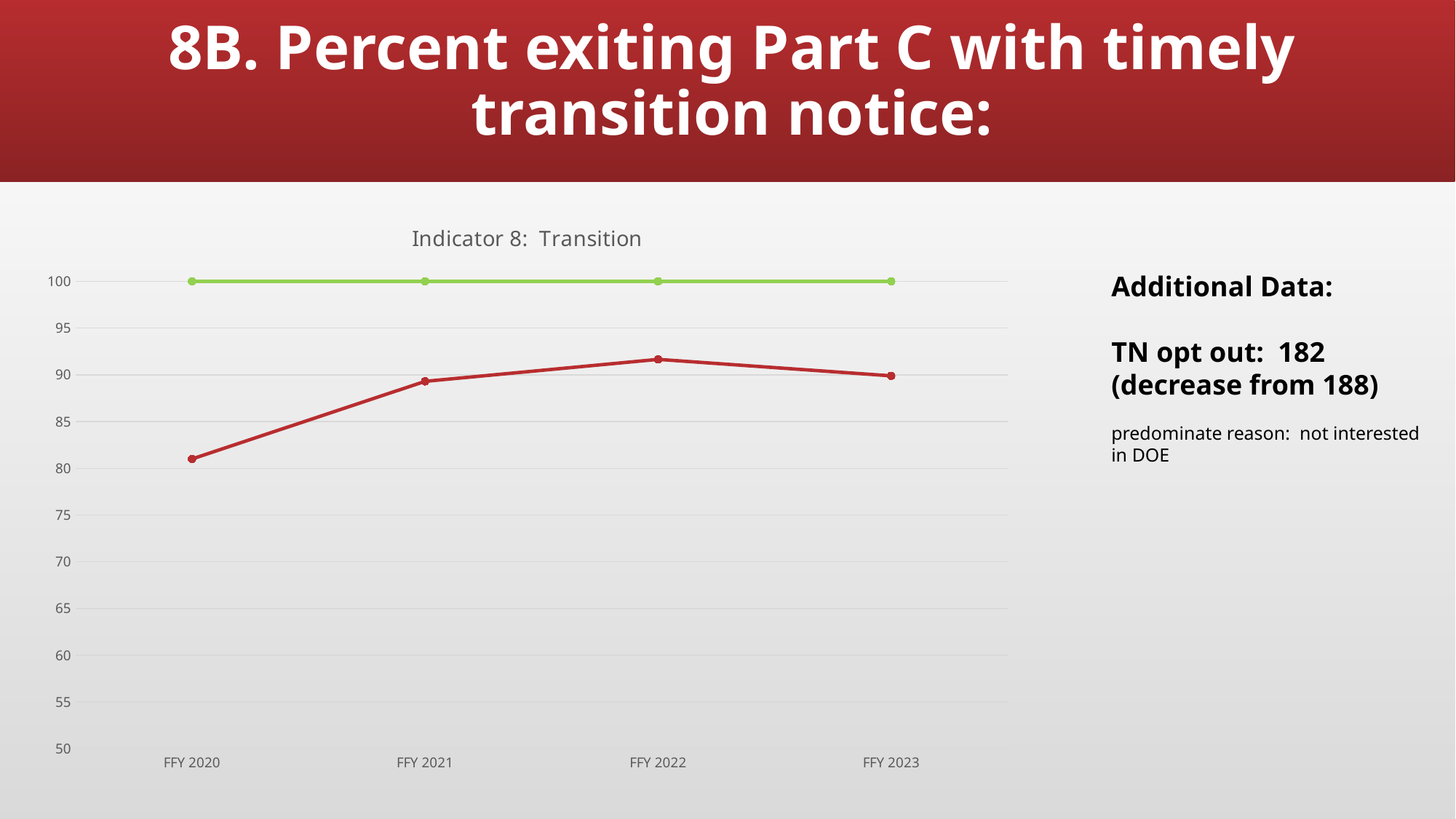
Is the value of the red line for FFY 2022 greater or less than 90? greater In which FFY does the red line have its lowest value? FFY 2020 What kind of chart is shown on the slide? line chart In which FFY does the red line reach its highest value? FFY 2022 Is the value of the red line for FFY 2023 greater or less than 85? greater How does the red line change from FFY 2020 to FFY 2022? it rises What value does the green line stay at across all four years? 100 Is the value of the red line for FFY 2020 greater or less than 85? less What is the title of the chart? Indicator 8: Transition How many FFY categories are shown on the x axis of the chart? 4 Which is larger on the red line, the value for FFY 2020 or the value for FFY 2021? FFY 2021